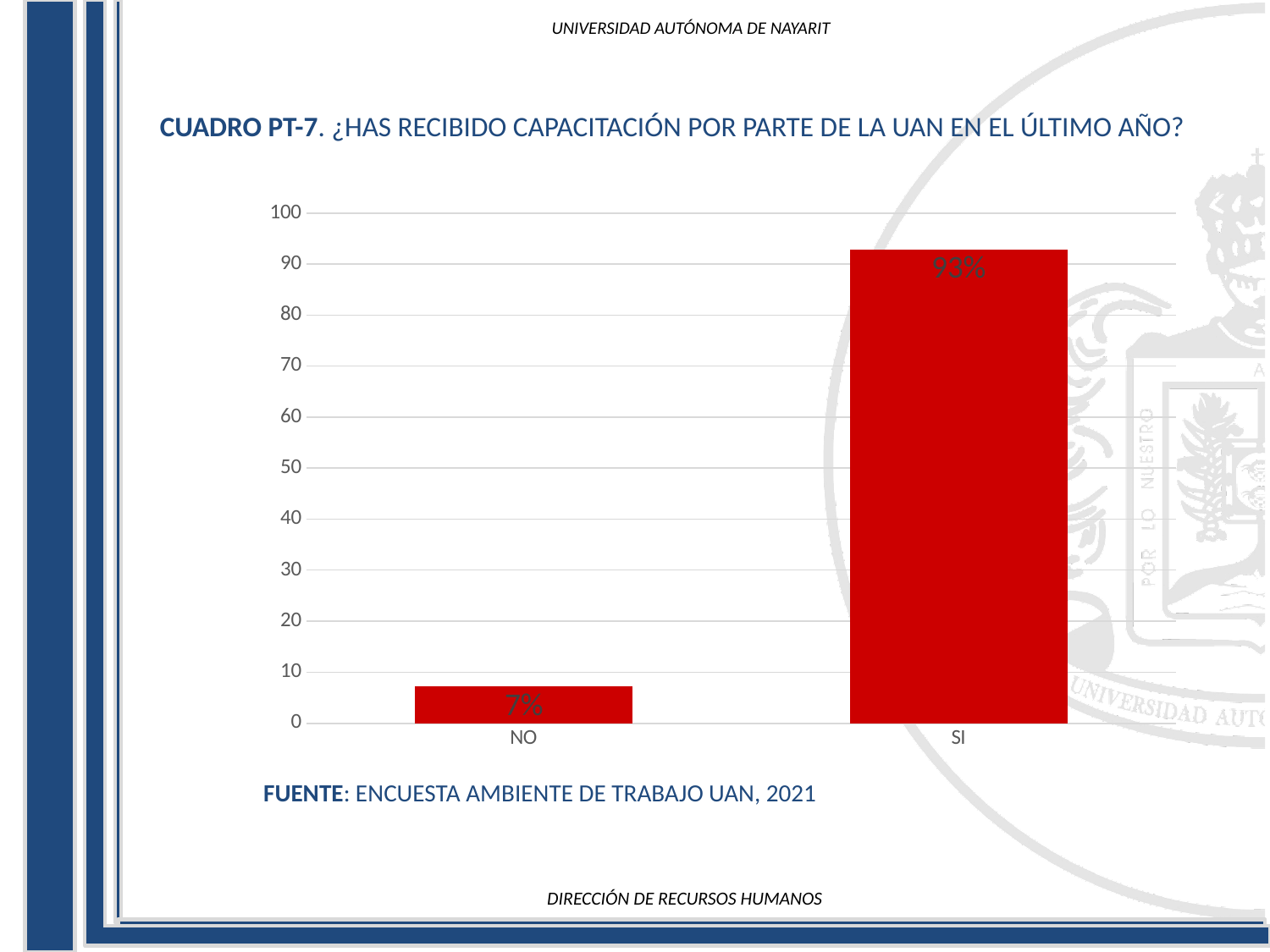
Is the value for NO greater or less than 10? less What is the maximum value shown on the vertical axis? 100 What is the value for NO? 7% How many categories are shown on the x axis? 2 Which category has the highest value? SI Which category has the lowest value? NO What is the value for SI? 93% Which is larger, the value for SI or the value for NO? SI What kind of chart is shown on the slide? bar chart What colour are the bars in the chart? red What is the difference between the values for SI and NO? 86% Is the value for SI greater or less than 90? greater